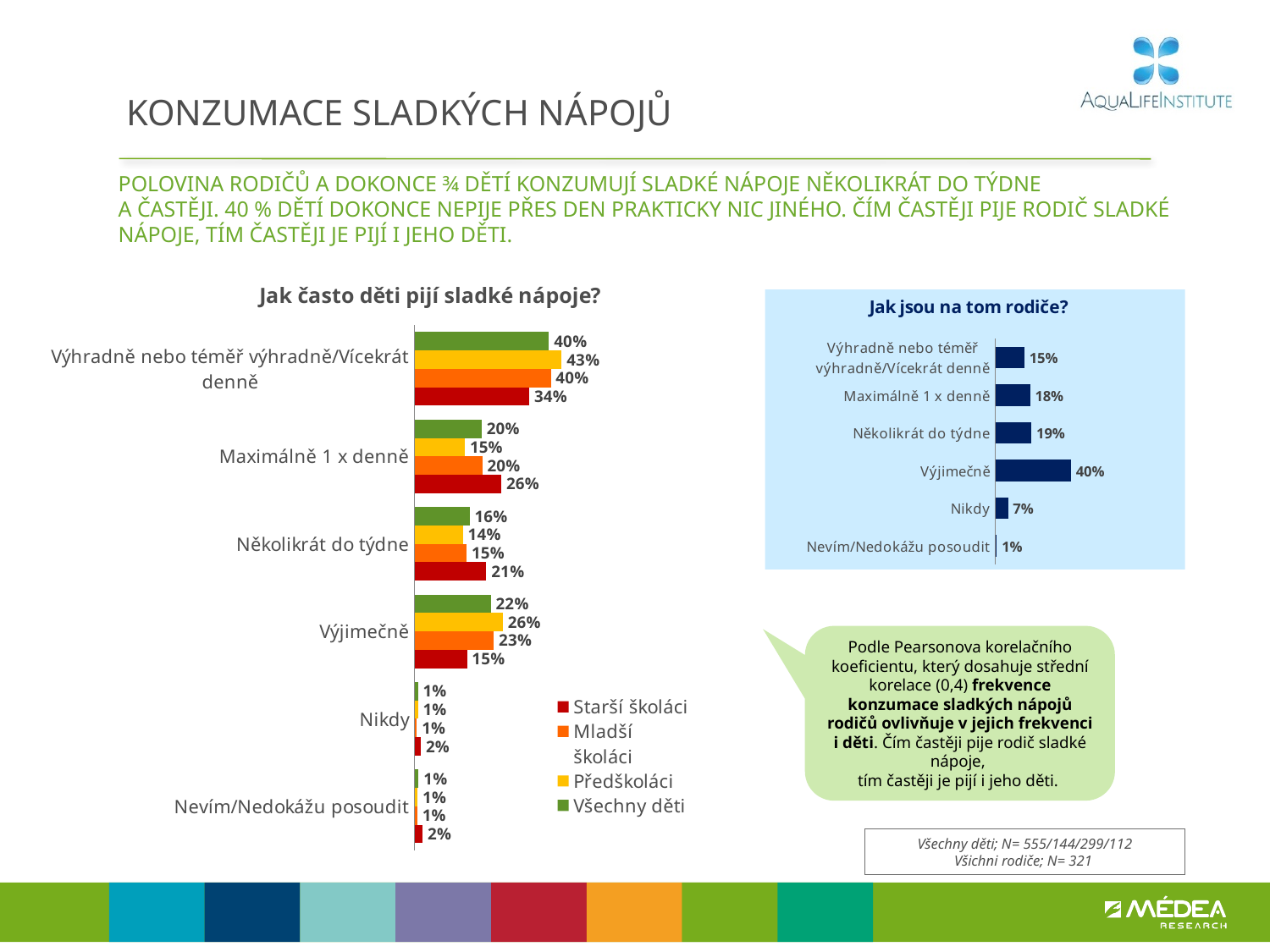
In the chart 'Jak často děti pijí sladké nápoje?', what is the value for 'Starší školáci' in the category 'Maximálně 1 x denně'? 26% In the chart 'Jak jsou na tom rodiče?', which category has the lowest value? Nevím/Nedokážu posoudit In the chart 'Jak často děti pijí sladké nápoje?', what is the value for 'Předškoláci' in the category 'Výhradně nebo téměř výhradně/Vícekrát denně'? 43% What type of chart is 'Jak často děti pijí sladké nápoje?'? Bar chart In the chart 'Jak jsou na tom rodiče?', what is the difference between 'Několikrát do týdne' and 'Maximálně 1 x denně'? 1% How many categories does the chart 'Jak jsou na tom rodiče?' show? 6 In the chart 'Jak jsou na tom rodiče?', what is the value for 'Výjimečně'? 40% In the chart 'Jak často děti pijí sladké nápoje?', which colour represents the series 'Všechny děti'? Green In the chart 'Jak často děti pijí sladké nápoje?', what is the difference between 'Předškoláci' and 'Starší školáci' in the category 'Výjimečně'? 11% How many series does the legend of the chart 'Jak často děti pijí sladké nápoje?' list? 4 In the chart 'Jak často děti pijí sladké nápoje?', which series has the highest value in the category 'Několikrát do týdne'? Starší školáci In the chart 'Jak často děti pijí sladké nápoje?', which is larger in the category 'Výjimečně': 'Předškoláci' or 'Starší školáci'? Předškoláci